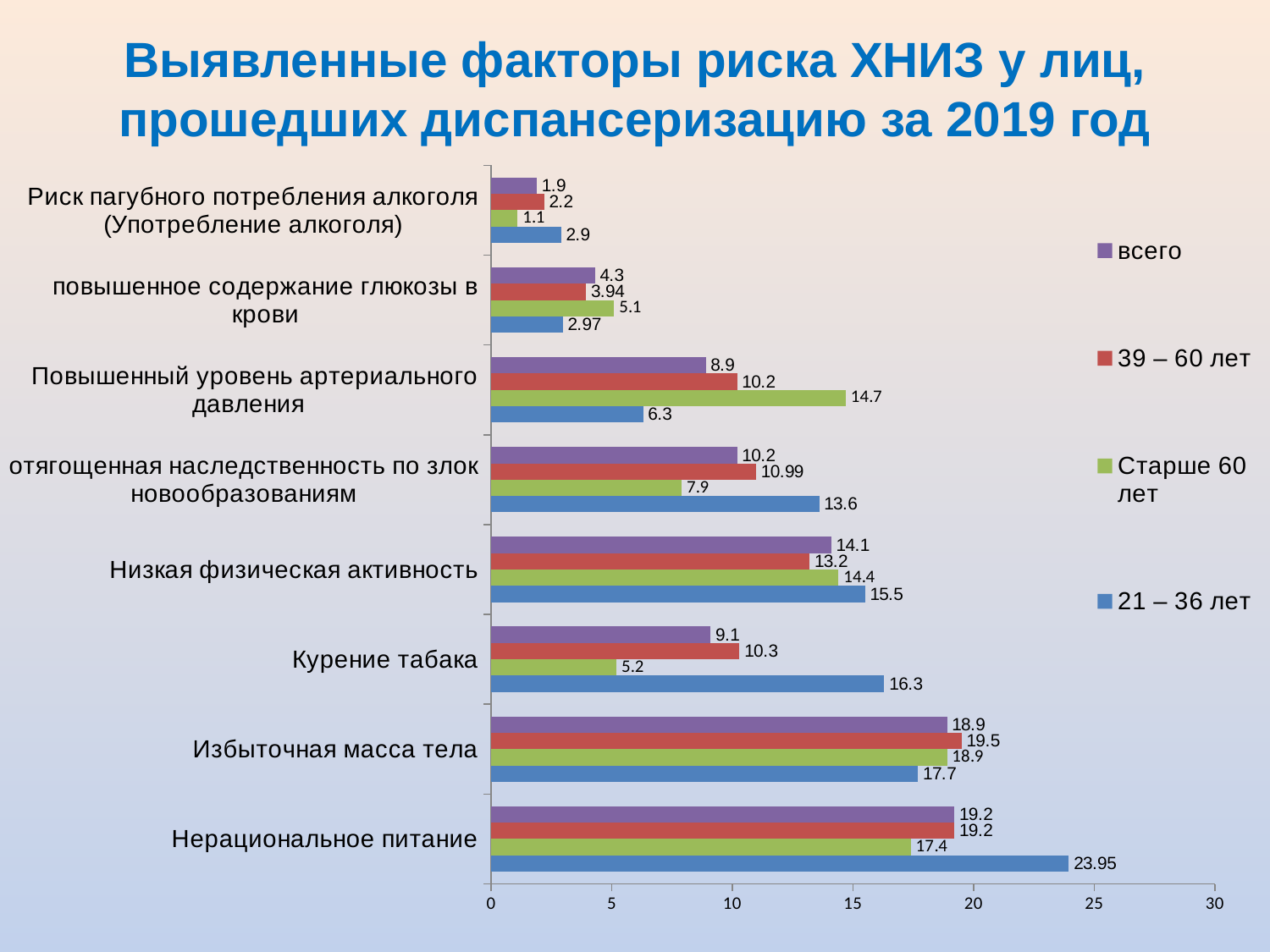
For 'Повышенный уровень артериального давления', which is larger: the 'Старше 60 лет' value or the '21 – 36 лет' value? Старше 60 лет What is the value for 'Курение табака' in the 'Старше 60 лет' series? 5.2 Is the '21 – 36 лет' value for 'Нерациональное питание' greater or less than 20? greater What is the value for 'Повышенный уровень артериального давления' in the '39 – 60 лет' series? 10.2 Which category has the highest value in the '21 – 36 лет' series? Нерациональное питание How many risk-factor categories are plotted on the chart? 8 How many series does the legend list? 4 Which category has the lowest value in the 'всего' series? Риск пагубного потребления алкоголя (Употребление алкоголя) What is the difference between the '21 – 36 лет' and 'Старше 60 лет' values for 'Курение табака'? 11.1 Which colour represents the '39 – 60 лет' series in the legend? red What is the value for 'Нерациональное питание' in the '21 – 36 лет' series? 23.95 What type of chart is shown on the slide? bar chart